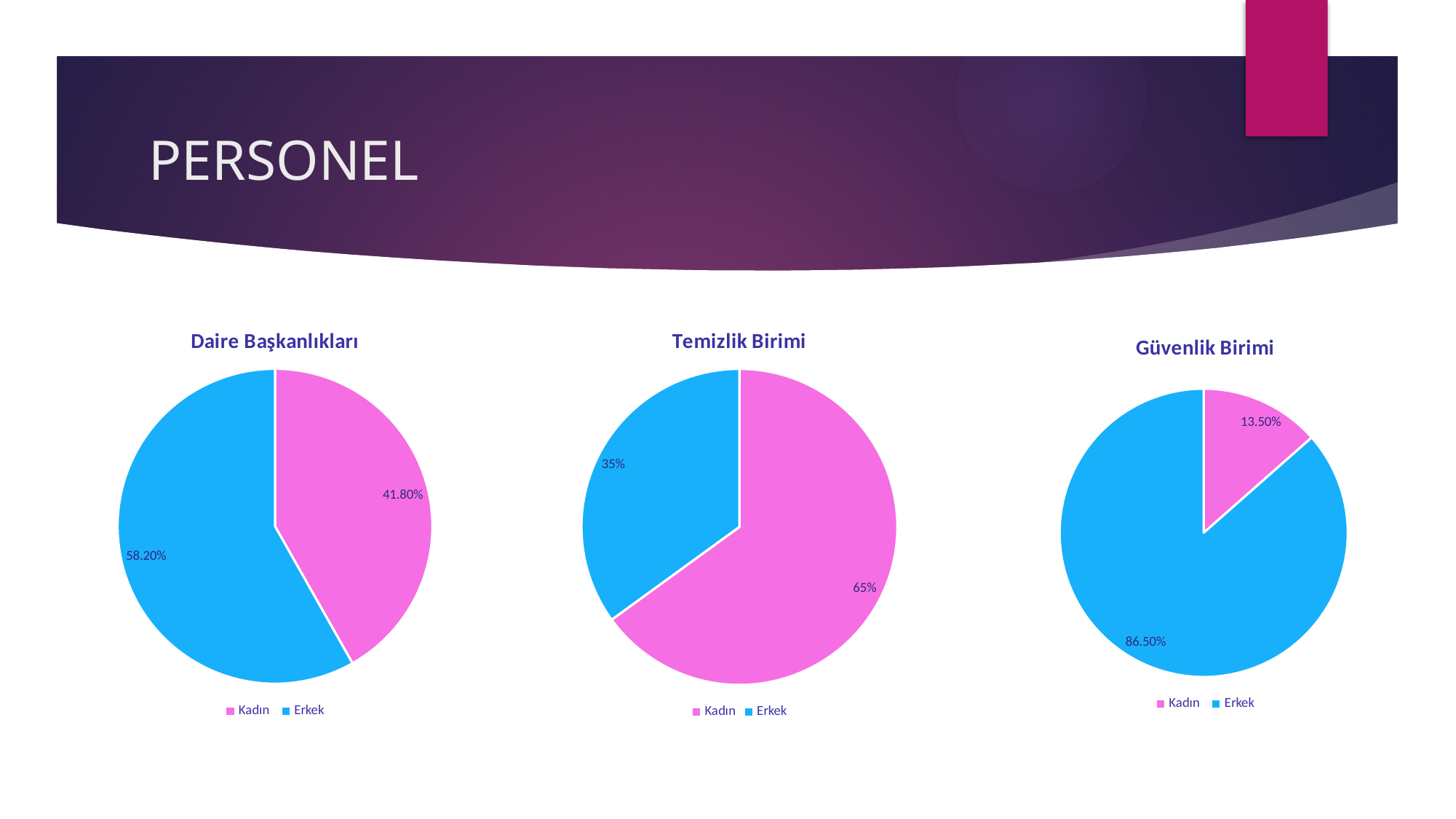
In the 'Temizlik Birimi' chart, what is the value for Kadın? 65% In the 'Daire Başkanlıkları' chart, what is the value for Erkek? 58.20% In the 'Daire Başkanlıkları' chart, which is larger, Kadın or Erkek? Erkek In the 'Güvenlik Birimi' chart, what is the difference between Erkek and Kadın? 73.00% In the 'Güvenlik Birimi' chart, which category is the smallest? Kadın In the 'Daire Başkanlıkları' chart, what share of the pie is Kadın? 41.80% In the 'Temizlik Birimi' chart, what share of the pie is Erkek? 35% In the 'Güvenlik Birimi' chart, what is the value for Erkek? 86.50% In the 'Güvenlik Birimi' chart, what is the value for Kadın? 13.50% What kind of chart is the 'Temizlik Birimi' chart? Pie chart How many categories does the legend of the 'Daire Başkanlıkları' chart list? 2 In the 'Temizlik Birimi' chart, which category is the largest? Kadın